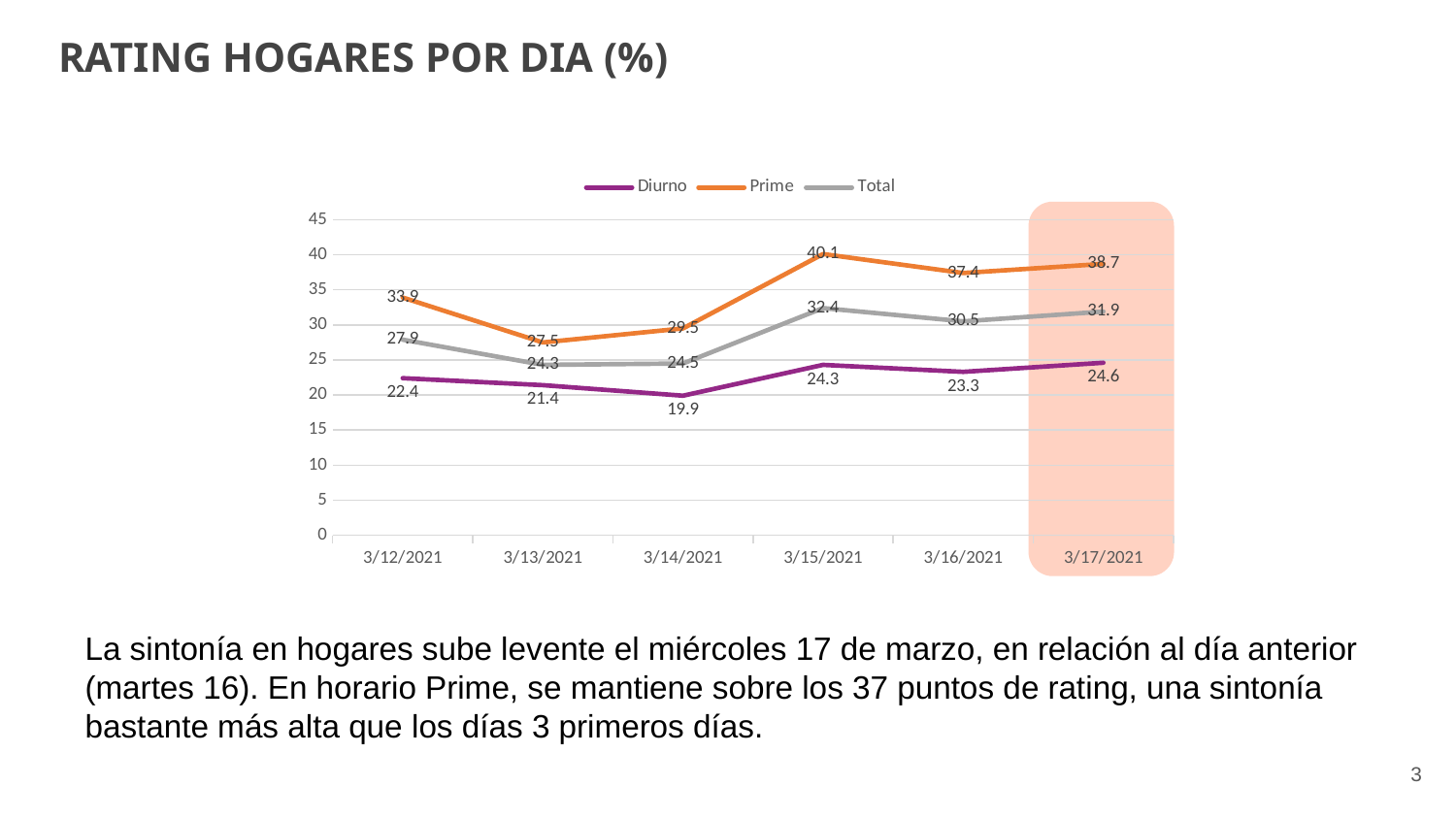
What type of chart is shown on the slide? line chart What is the difference between the Prime and Diurno values on 3/17/2021? 14.1 Is the Prime value on 3/13/2021 greater or less than 30? less On which date is the Diurno series lowest? 3/14/2021 Which series is drawn in orange? Prime How many dates are shown on the x axis? 6 What is the Total value on 3/17/2021? 31.9 What is the Prime value on 3/15/2021? 40.1 Which is larger, the Total value on 3/12/2021 or the Total value on 3/13/2021? 3/12/2021 On which date is the Prime series highest? 3/15/2021 What is the Diurno value on 3/14/2021? 19.9 How many series does the legend list? 3